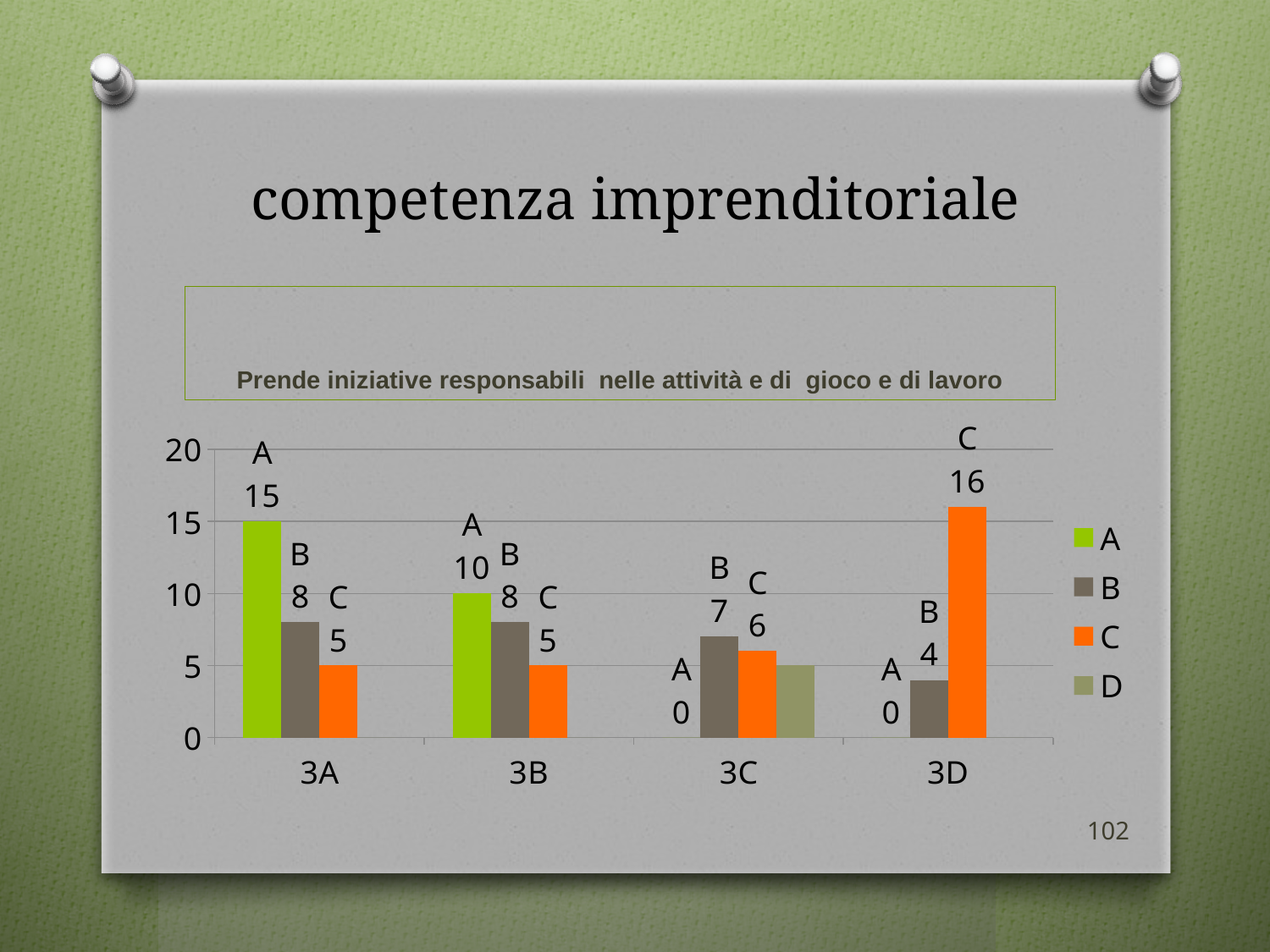
What kind of chart is shown on the slide? bar chart What is the value for series B in category 3C? 7 What is the value for series C in category 3D? 16 What is the value for series A in category 3A? 15 Which series has the lowest value in category 3C? A What is the difference between the value for series A and the value for series C in category 3A? 10 How many series does the legend list? 4 Which series has the highest value in category 3D? C What is the value for series A in category 3B? 10 Is the value for series D in category 3C greater or less than 10? less How many categories are shown on the x axis? 4 Which is larger: the value for series B in 3B or the value for series B in 3D? B in 3B